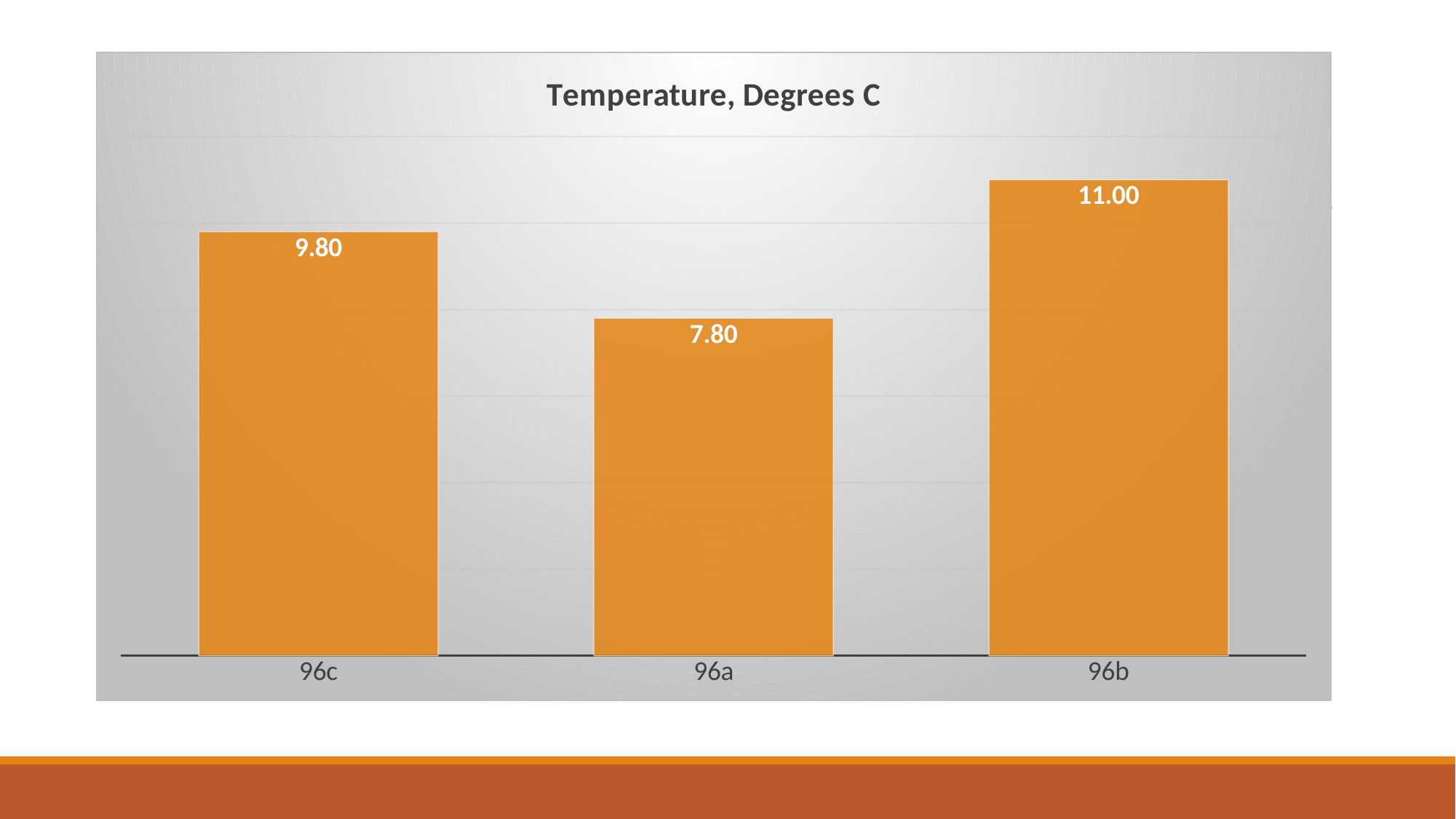
What is the temperature value for 96b? 11.00 Which has a higher temperature, 96c or 96a? 96c What kind of chart is shown on the slide? bar chart Which category has the highest temperature? 96b What is the difference between the temperature for 96b and the temperature for 96a? 3.20 What is the temperature value for 96c? 9.80 Which category has the lowest temperature? 96a How many categories are shown on the chart? 3 What is the difference between the temperature for 96c and the temperature for 96a? 2.00 What is the temperature value for 96a? 7.80 Which has a higher temperature, 96b or 96c? 96b What is the title of the chart? Temperature, Degrees C